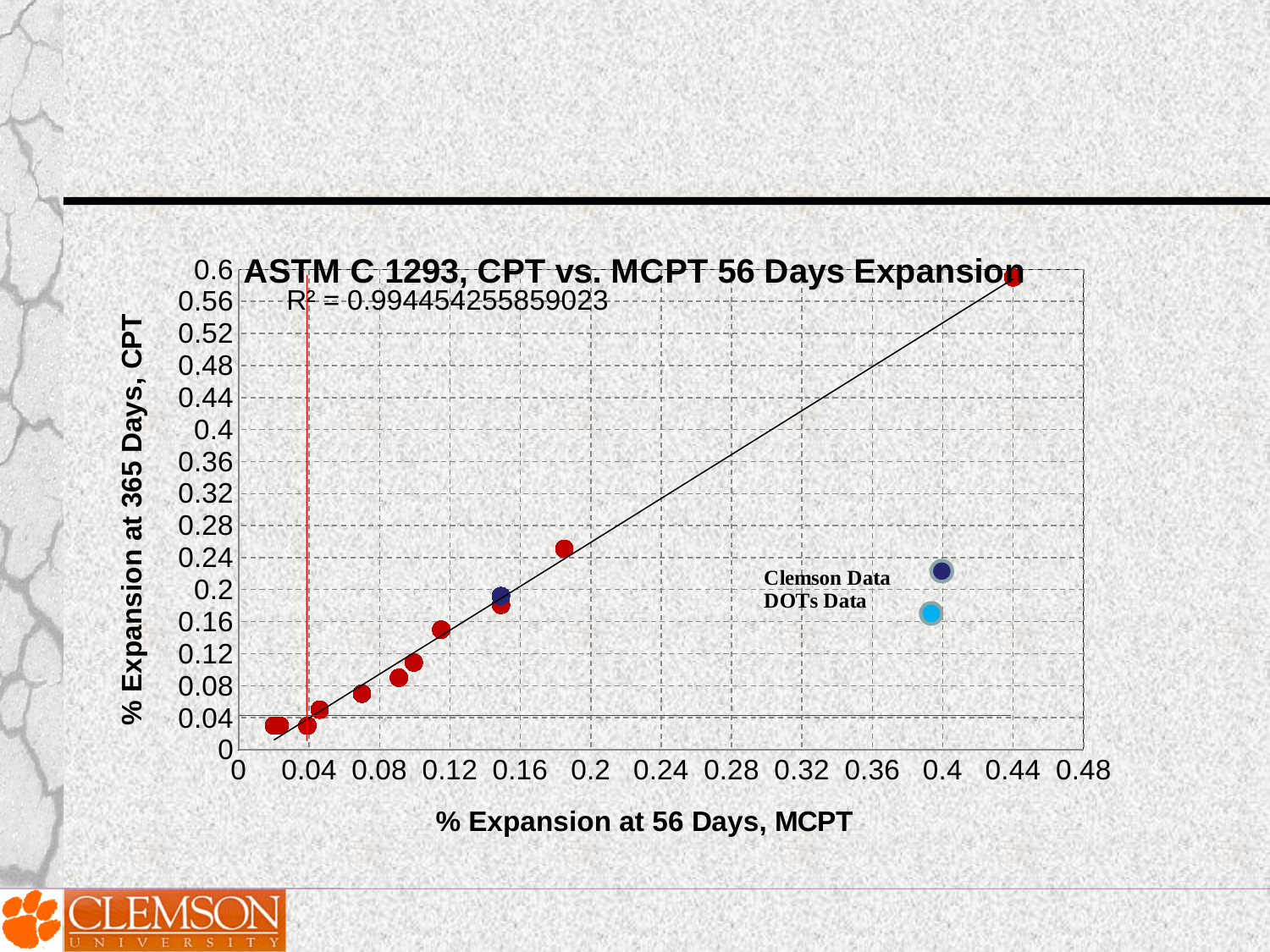
What R² value is printed on the chart? 0.994454255859023 What is the maximum value shown on the y axis? 0.6 What is the label of the x axis? % Expansion at 56 Days, MCPT Is the y value of the point plotted near x = 0.185 greater or less than 0.2? greater Is the y value of the point plotted near x = 0.07 greater or less than 0.12? less What kind of chart is shown on the slide? scatter chart What is the title of the chart? ASTM C 1293, CPT vs. MCPT 56 Days Expansion What is the maximum value shown on the x axis? 0.48 What is the label of the y axis? % Expansion at 365 Days, CPT Do the plotted values rise or fall as the x-axis value increases? rise Is the y value of the point plotted near x = 0.44 greater or less than 0.52? greater